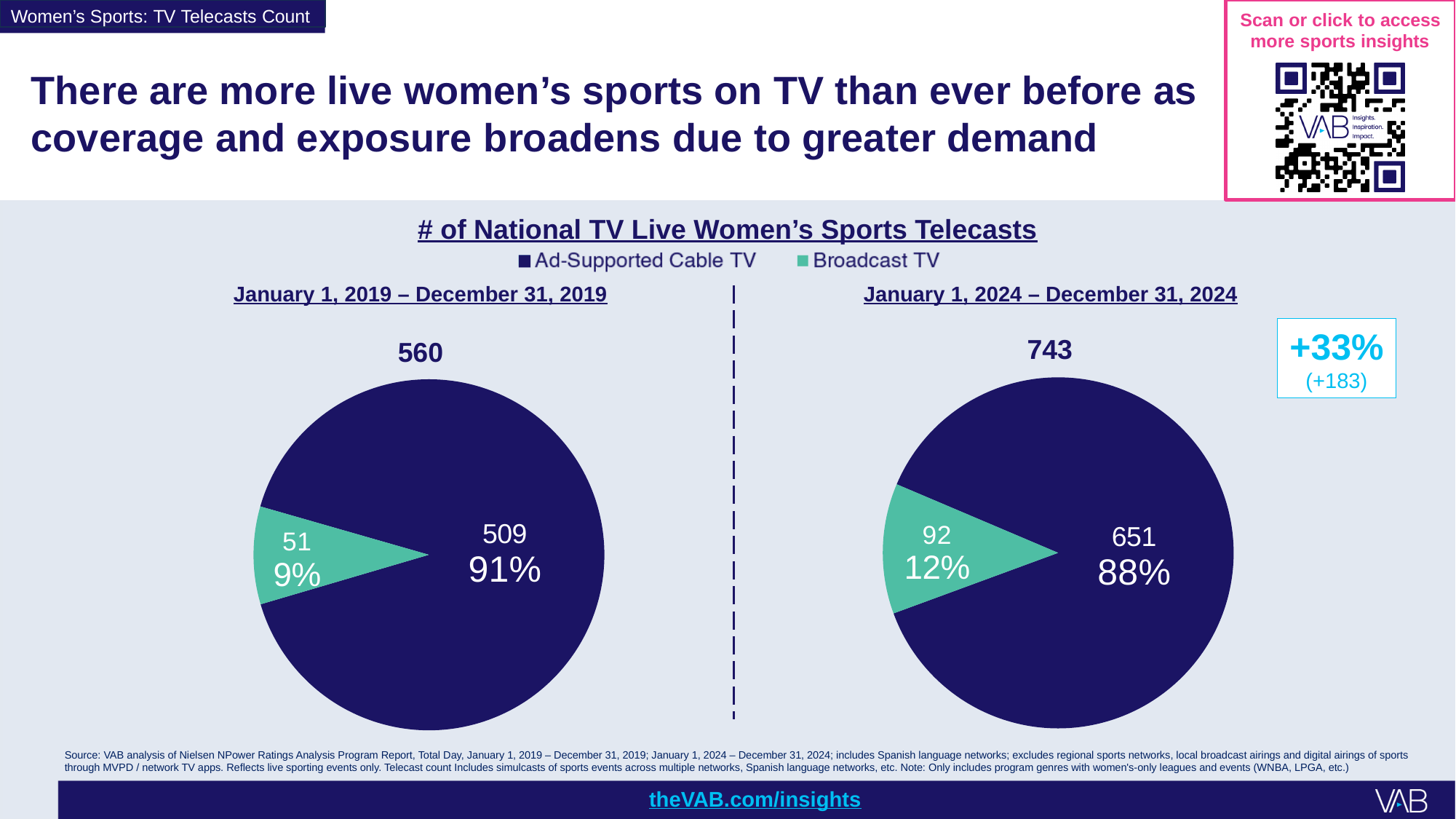
In the 2024 pie chart, how many telecasts were on Broadcast TV? 92 In the 2019 pie chart, how many telecasts were on Ad-Supported Cable TV? 509 In the 2024 pie chart, what share of telecasts was on Ad-Supported Cable TV? 88% How many series does the legend list? 2 In the 2019 pie chart, which category has the smaller number of telecasts? Broadcast TV Is the number of Broadcast TV telecasts larger in the 2019 pie chart or the 2024 pie chart? 2024 What is the total number of telecasts shown for the 2019 pie chart? 560 In the 2024 pie chart, which category has the larger number of telecasts? Ad-Supported Cable TV What is the difference between Ad-Supported Cable TV telecasts in 2024 and in 2019? 142 What type of chart is used to show the telecast counts? Pie chart What is the total number of telecasts shown for the 2024 pie chart? 743 In the 2019 pie chart, what share of telecasts was on Broadcast TV? 9%